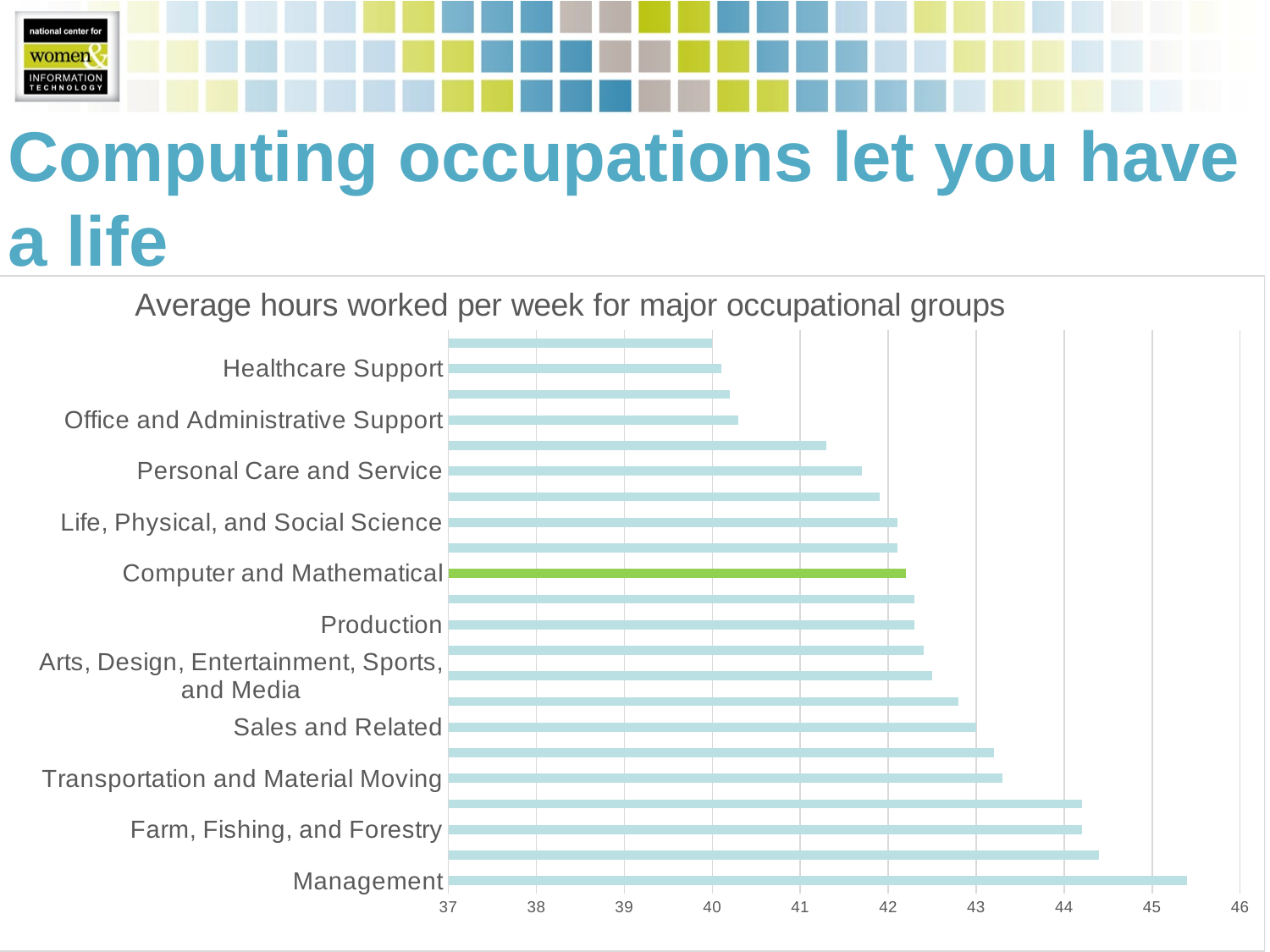
Is the value for Transportation and Material Moving greater or less than 44? less Do the bar lengths increase or decrease going from the top of the chart to the bottom? increase Which has a higher value, Farm, Fishing, and Forestry or Production? Farm, Fishing, and Forestry Is the value for Farm, Fishing, and Forestry greater or less than 45? less Is the value for Management greater or less than 45? greater What is the title of the chart? Average hours worked per week for major occupational groups Which bar is highlighted in a different colour (green) from the others? Computer and Mathematical What kind of chart is shown on the slide? bar chart Which has a higher value, Management or Computer and Mathematical? Management Which occupational group has the highest average hours worked per week? Management